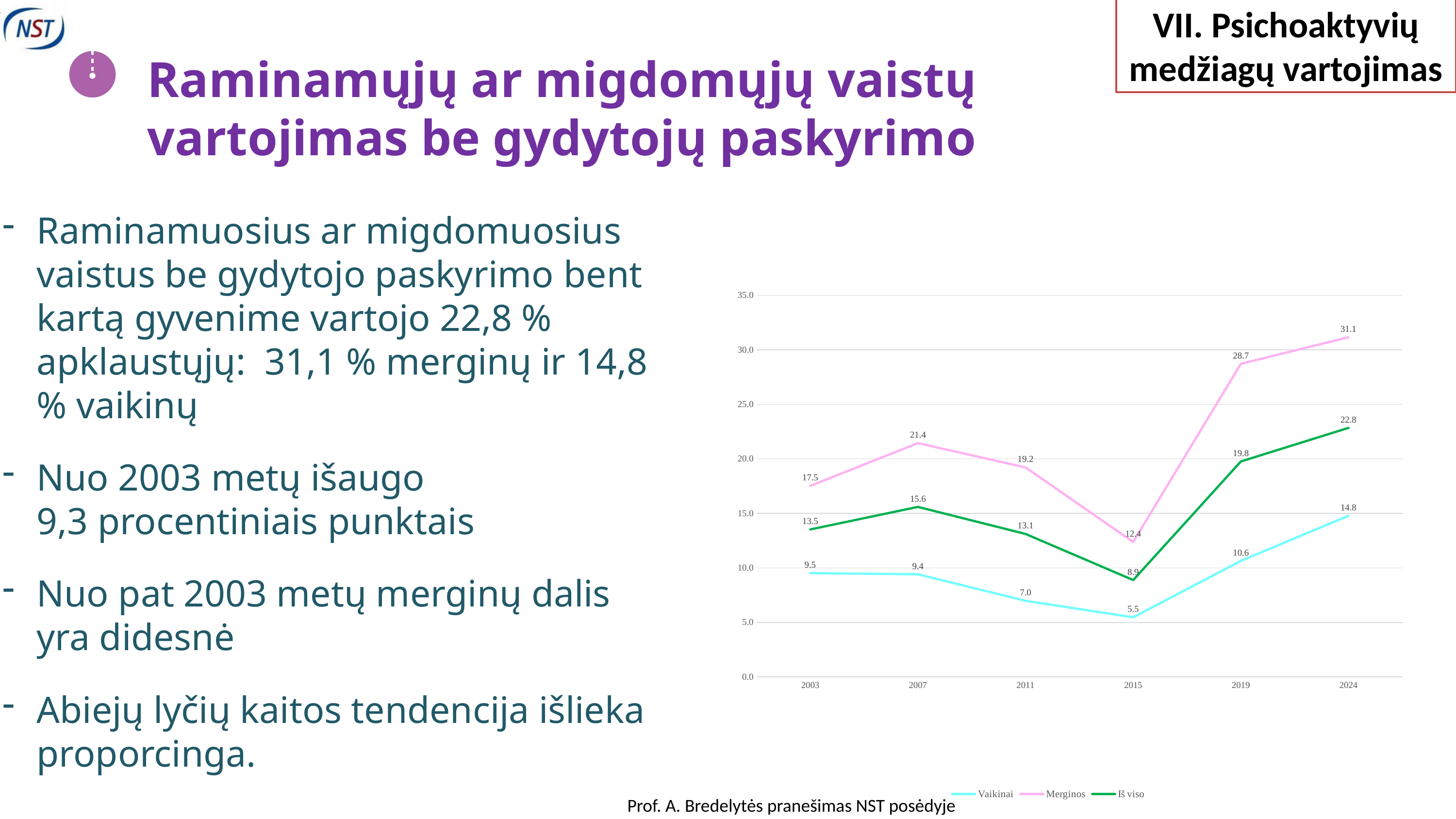
In which year is the Iš viso value the lowest? 2015 What is the value for Vaikinai in 2015? 5.5 Does the Vaikinai series rise or fall between 2015 and 2024? rise What is the difference between the Merginos and Vaikinai values in 2019? 18.1 What is the value for Iš viso in 2007? 15.6 What type of chart is shown on the slide? line chart How many years are shown on the x axis of the chart? 6 How many series does the chart legend list? 3 In which year is the Merginos value the highest? 2024 What is the value for Merginos in 2024? 31.1 Which series is drawn in pink on the chart? Merginos Which is larger in 2003: the Vaikinai value or the Iš viso value? Iš viso